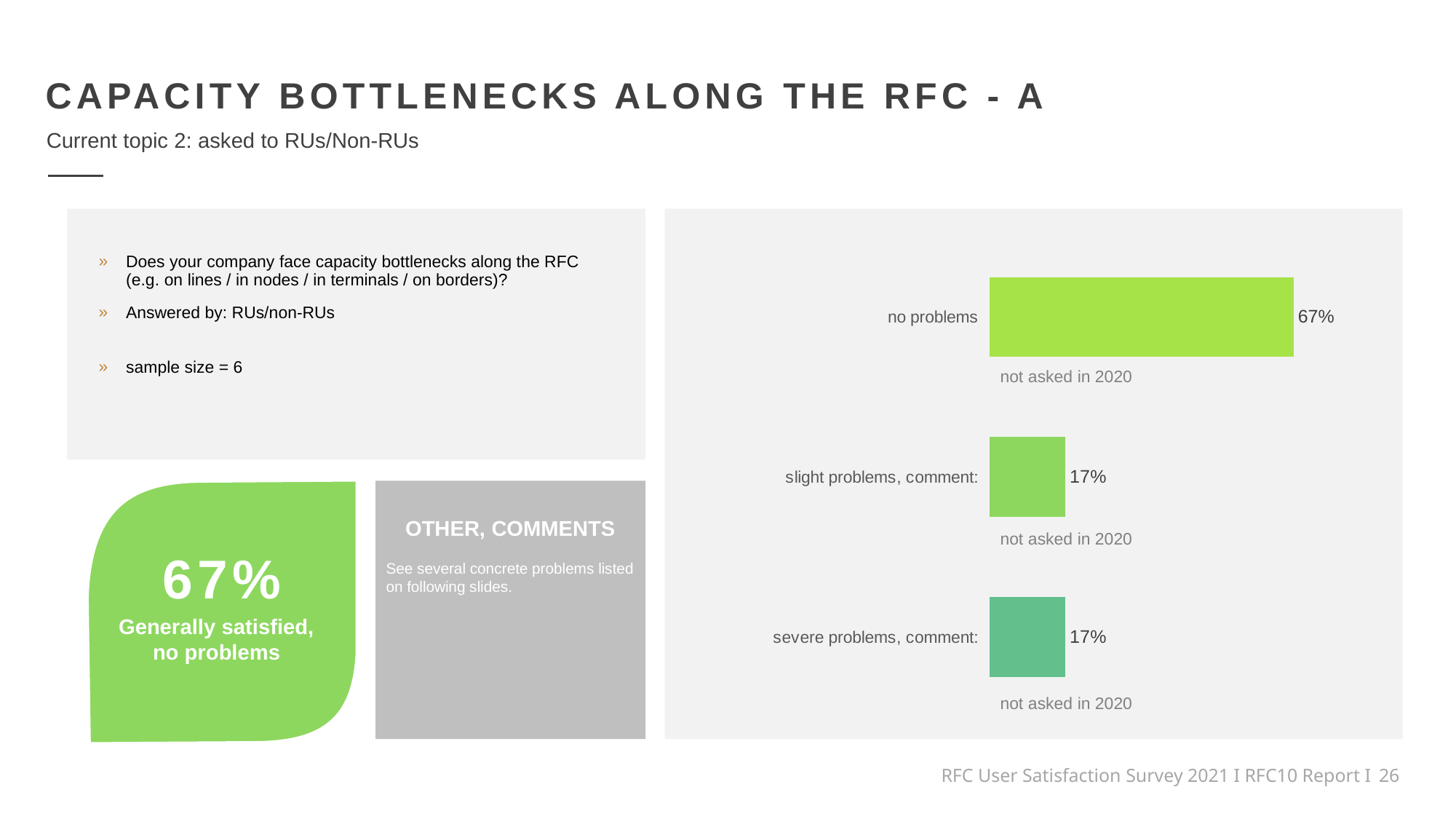
What percentage of respondents reported no problems with capacity bottlenecks along the RFC? 67% What type of chart is shown on the slide? bar chart What percentage of respondents reported slight problems? 17% Which is larger: the value for 'no problems' or the value for 'slight problems, comment:'? no problems What is the total of the three percentages shown in the chart? 101% How many categories are shown in the chart? 3 What is the sample size stated on the slide for this question? 6 What percentage of respondents reported severe problems? 17% Which category has the highest value in the chart? no problems What is the difference between the 'no problems' value and the 'severe problems, comment:' value? 50% What note appears beneath each bar in the chart? not asked in 2020